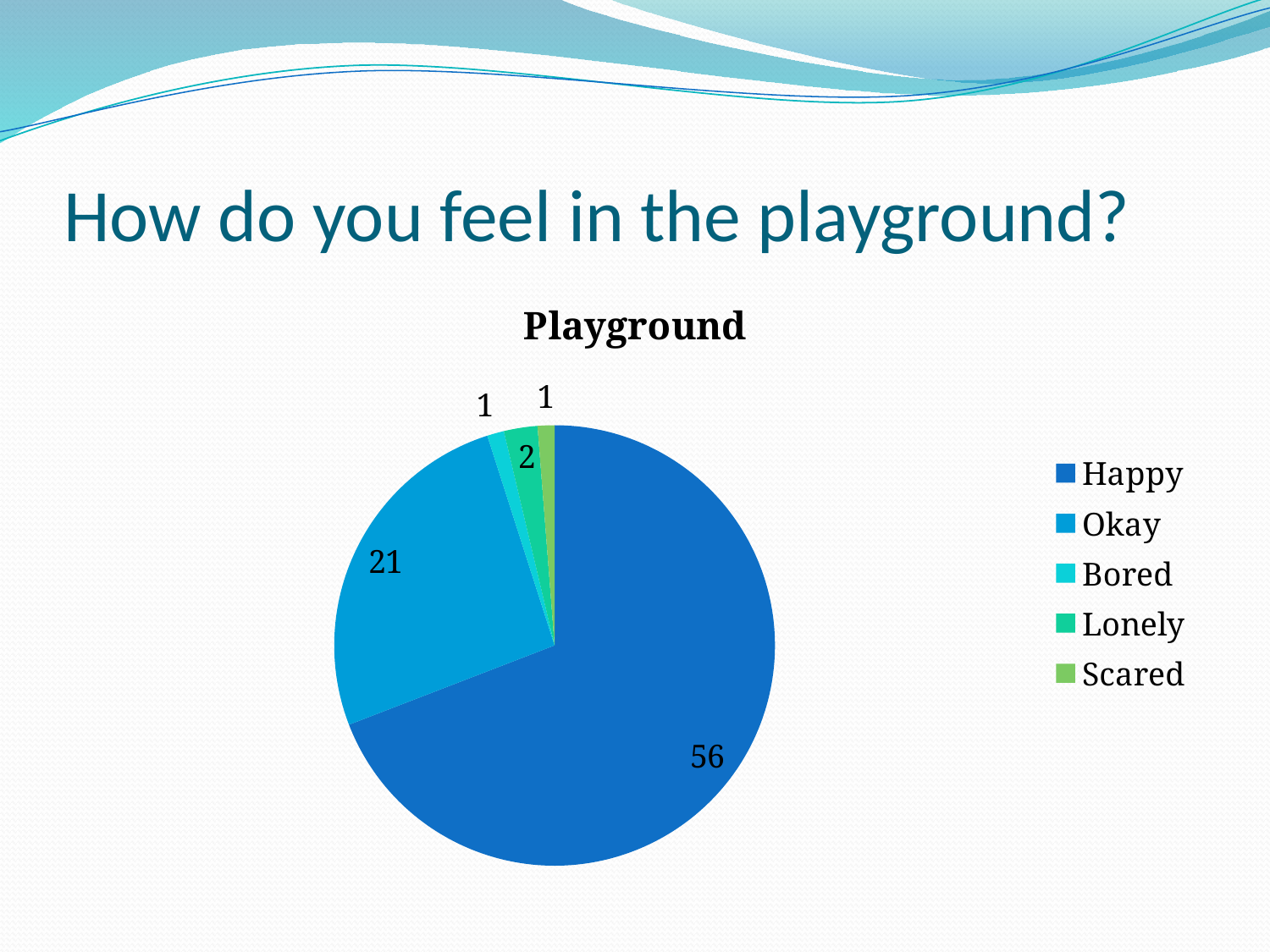
Which is larger, the value for Lonely or the value for Scared? Lonely Which category has the largest slice? Happy What is the total of all the slices in the pie chart? 81 What is the difference between the values for Happy and Okay? 35 What is the value for Bored? 1 What is the value for Okay? 21 What is the title of the chart? Playground Which legend entry is listed last? Scared How many categories does the pie chart have? 5 What is the value for Lonely? 2 What is the value for Happy? 56 What type of chart is shown on the slide? pie chart